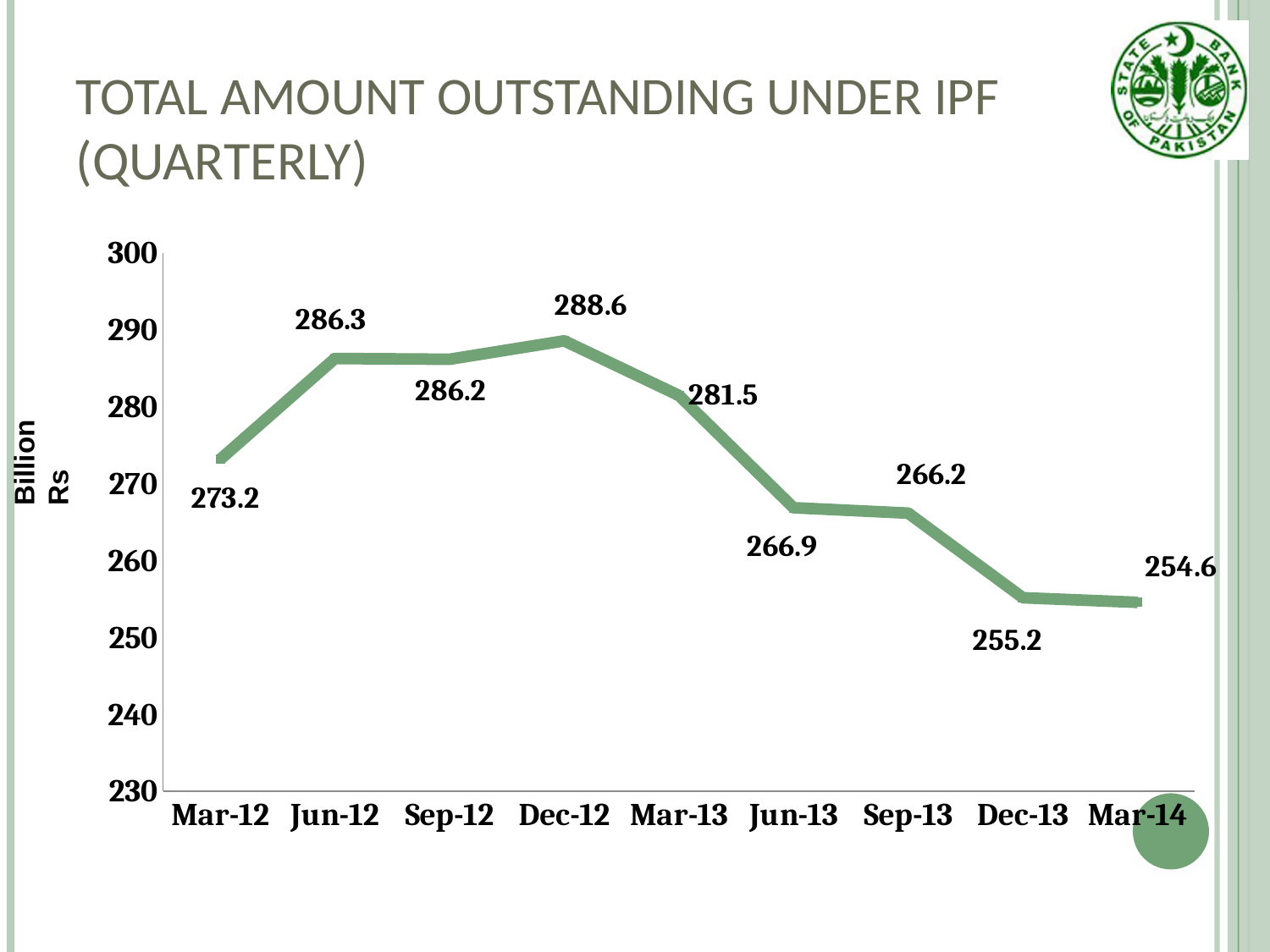
What is the total amount outstanding under IPF for Dec-12? 288.6 What type of chart is shown on the slide? Line chart Does the value rise or fall from Dec-12 to Mar-14? Fall Which quarter has the lowest amount outstanding? Mar-14 What is the value plotted for Mar-14? 254.6 By how much did the value increase from Mar-12 to Jun-12? 13.1 Which quarter has the highest amount outstanding? Dec-12 How many quarterly data points are plotted on the chart? 9 Which is larger, the value for Jun-12 or the value for Sep-12? Jun-12 What is the value plotted for Jun-13? 266.9 What is the label on the vertical axis of the chart? Billion Rs What is the difference between the values for Dec-12 and Mar-14? 34.0